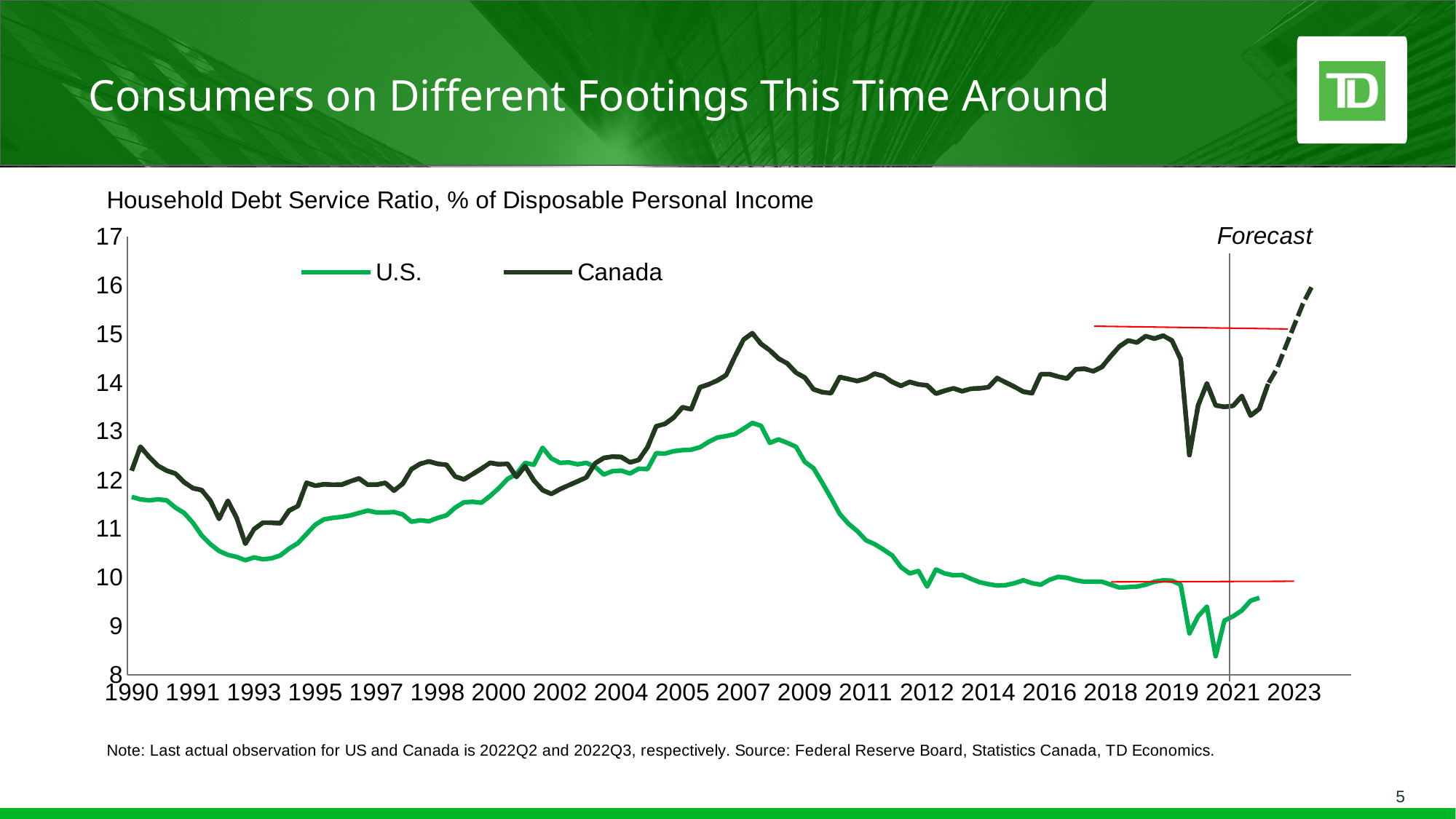
Does the U.S. line rise or fall between 2009 and 2012? Fall In 2019, which series has the higher value, U.S. or Canada? Canada Is the forecast value for Canada at the end of 2023 greater or less than 15? greater Is the value for the U.S. at its 2021 low point greater or less than 9? less What are the two series named in the legend? U.S. and Canada Is the value for the U.S. in 2011 greater or less than 10? greater What is the title of the chart? Household Debt Service Ratio, % of Disposable Personal Income How many series does the legend list? 2 What kind of chart is shown on the slide? Line chart Which series reaches the highest value anywhere on the chart? Canada